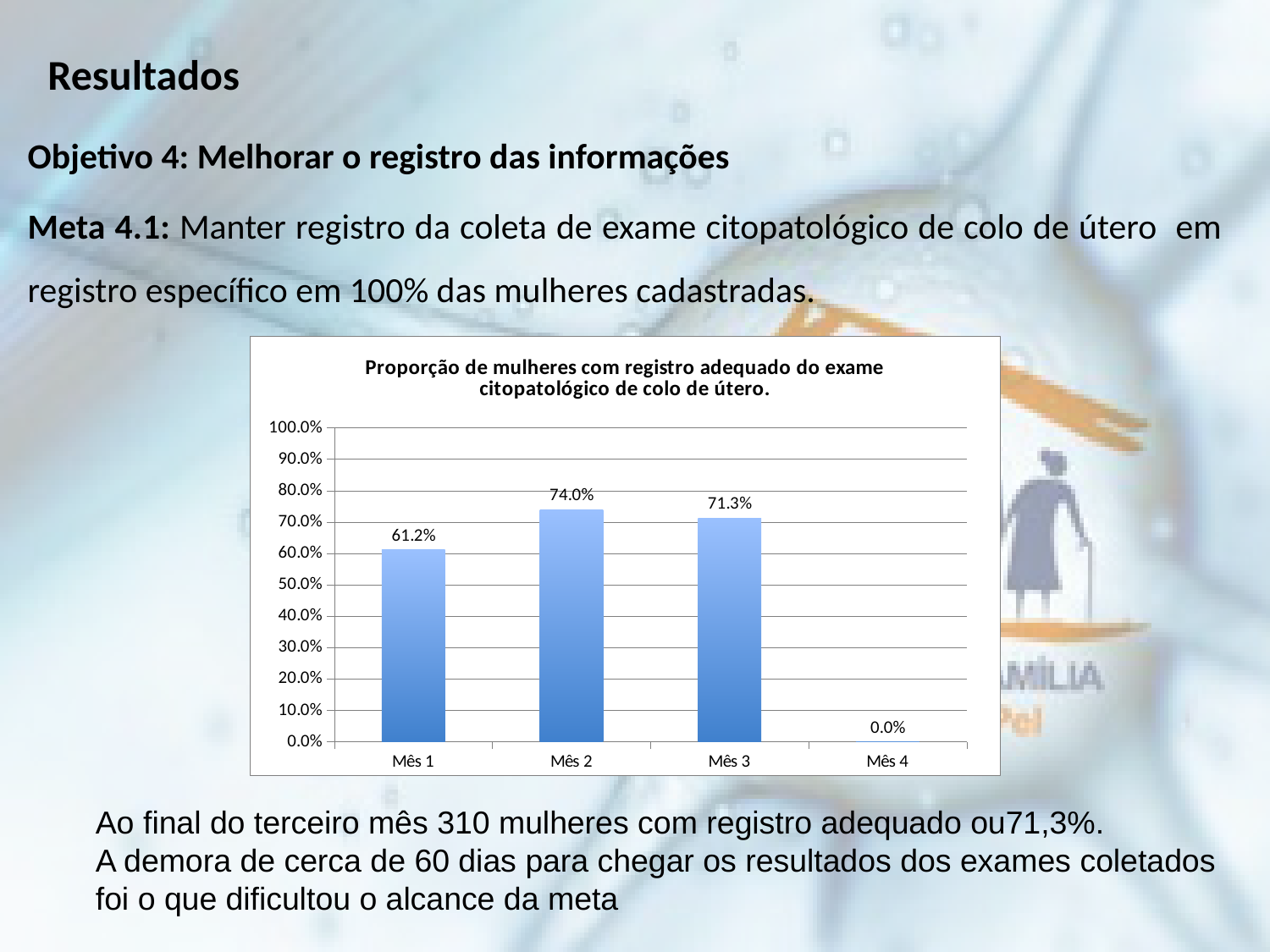
What kind of chart is shown on the slide? bar chart What is the title of the chart? Proporção de mulheres com registro adequado do exame citopatológico de colo de útero. Which month has the lowest value? Mês 4 What is the difference between the values for Mês 2 and Mês 1? 12.8% Which month has the highest value? Mês 2 What is the value for Mês 1? 61.2% How many months are shown on the x axis? 4 Is the value for Mês 1 greater or less than 70.0%? less What is the value for Mês 3? 71.3% What is the value for Mês 2? 74.0% What is the value for Mês 4? 0.0% Which is larger, the value for Mês 2 or Mês 3? Mês 2